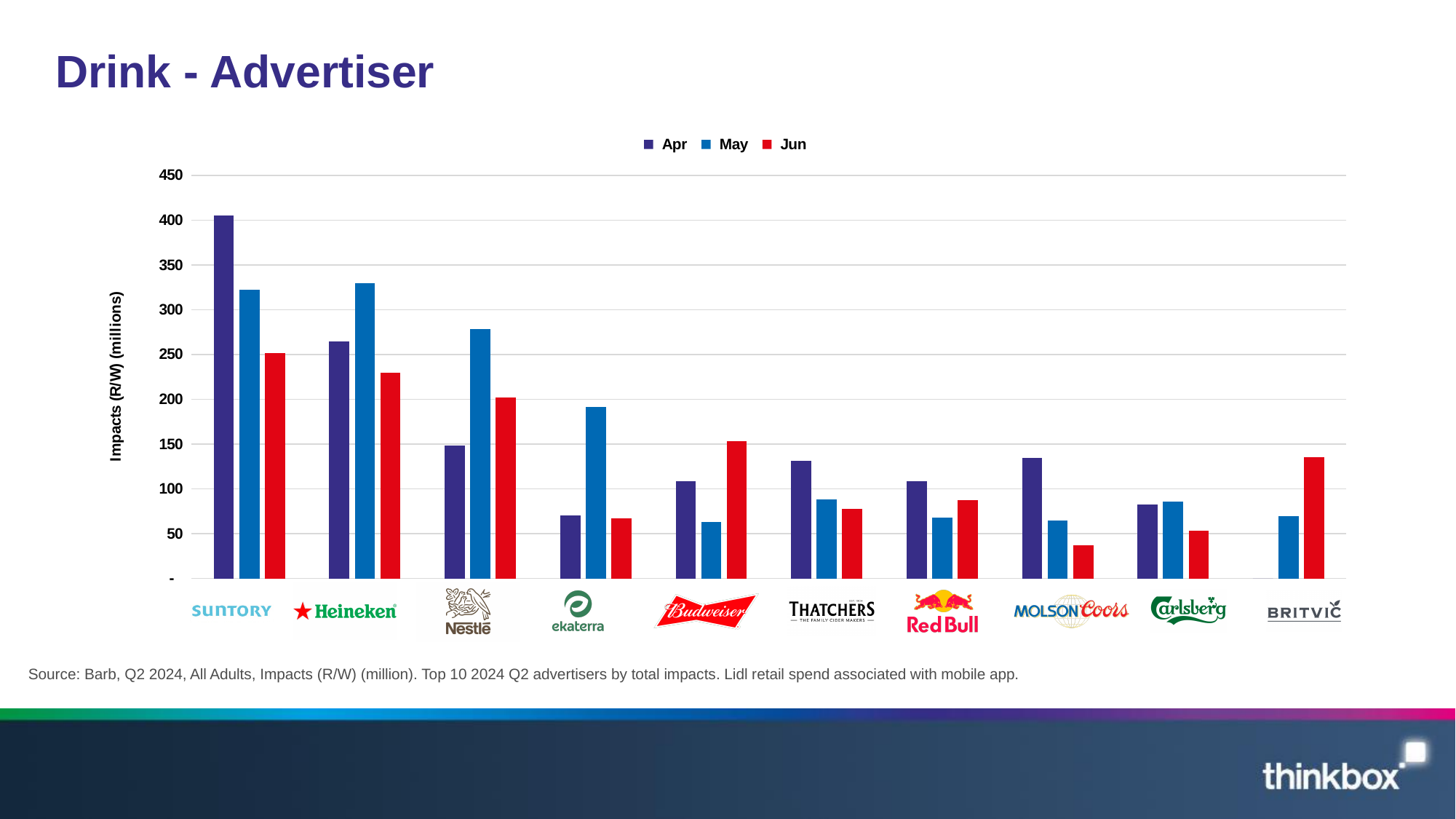
Is the May value for Nestle greater or less than 250? greater Is the Jun value for Molson Coors greater or less than 50? less How many advertisers are shown along the x axis? 10 How many series does the legend list? 3 Which advertiser has no Apr bar shown? Britvic Which advertiser has the highest Apr value? Suntory Do Suntory's values rise or fall from Apr to Jun? fall For Budweiser, which is larger: the Apr value or the Jun value? Jun What kind of chart is shown on the slide? bar chart Is the Apr value for Suntory greater or less than 350? greater Which advertiser has the lowest Jun value? Molson Coors For Heineken, which is larger: the Apr value or the May value? May